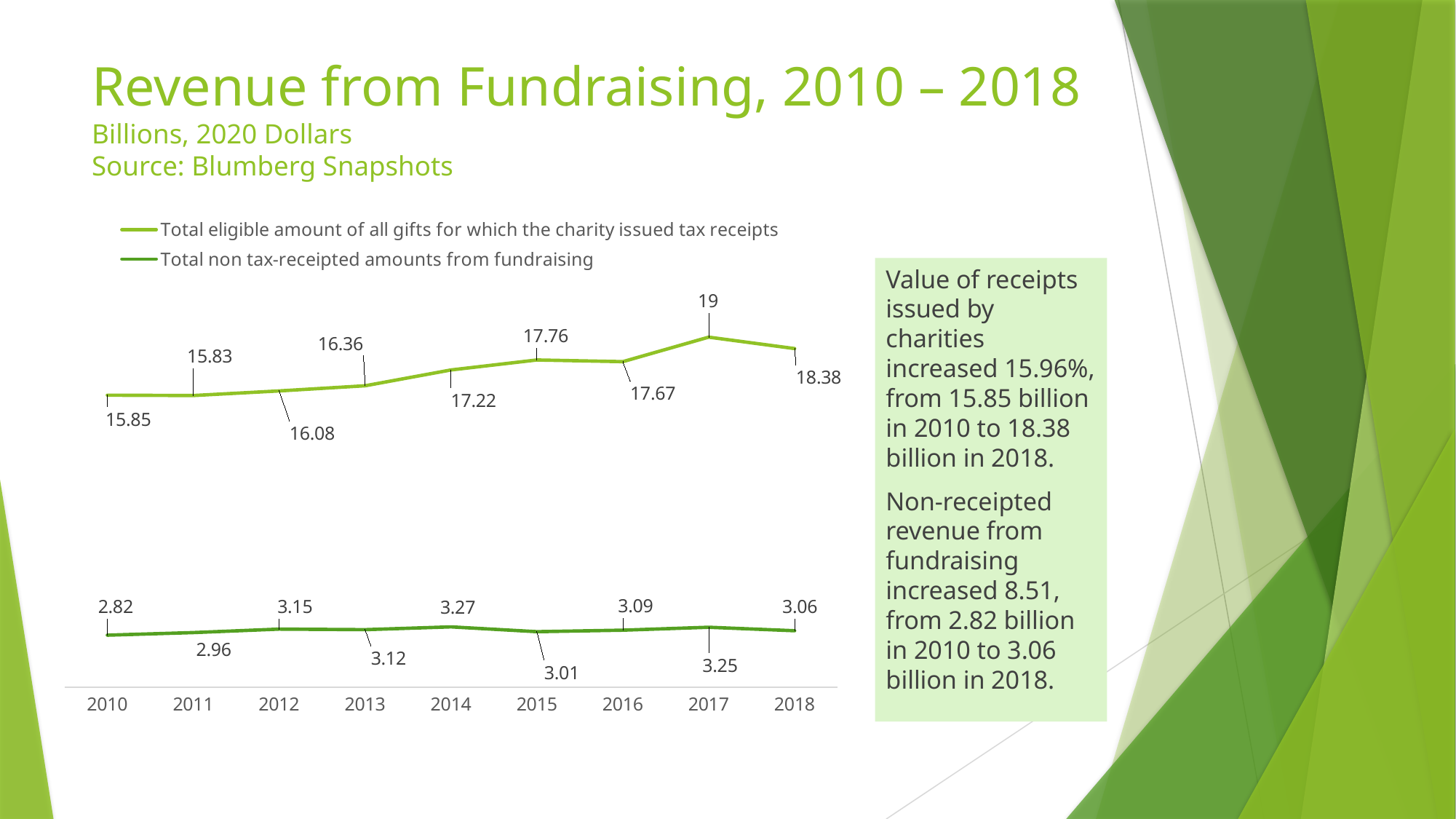
What is the value for 'Total eligible amount of all gifts for which the charity issued tax receipts' in 2017? 19 What is the value for 'Total eligible amount of all gifts for which the charity issued tax receipts' in 2013? 16.36 What is the value for 'Total non tax-receipted amounts from fundraising' in 2014? 3.27 What is the title of the chart on the slide? Revenue from Fundraising, 2010 – 2018 What kind of chart is shown on the slide? Line chart What is the difference between the 2018 and 2010 values for 'Total eligible amount of all gifts for which the charity issued tax receipts'? 2.53 Which is larger for 'Total non tax-receipted amounts from fundraising': the value in 2012 or the value in 2015? 2012 Does 'Total eligible amount of all gifts for which the charity issued tax receipts' rise or fall from 2010 to 2017? Rise In which year is 'Total eligible amount of all gifts for which the charity issued tax receipts' highest? 2017 How many years are plotted on the x axis? 9 How many series does the legend list? 2 In which year is 'Total non tax-receipted amounts from fundraising' lowest? 2010